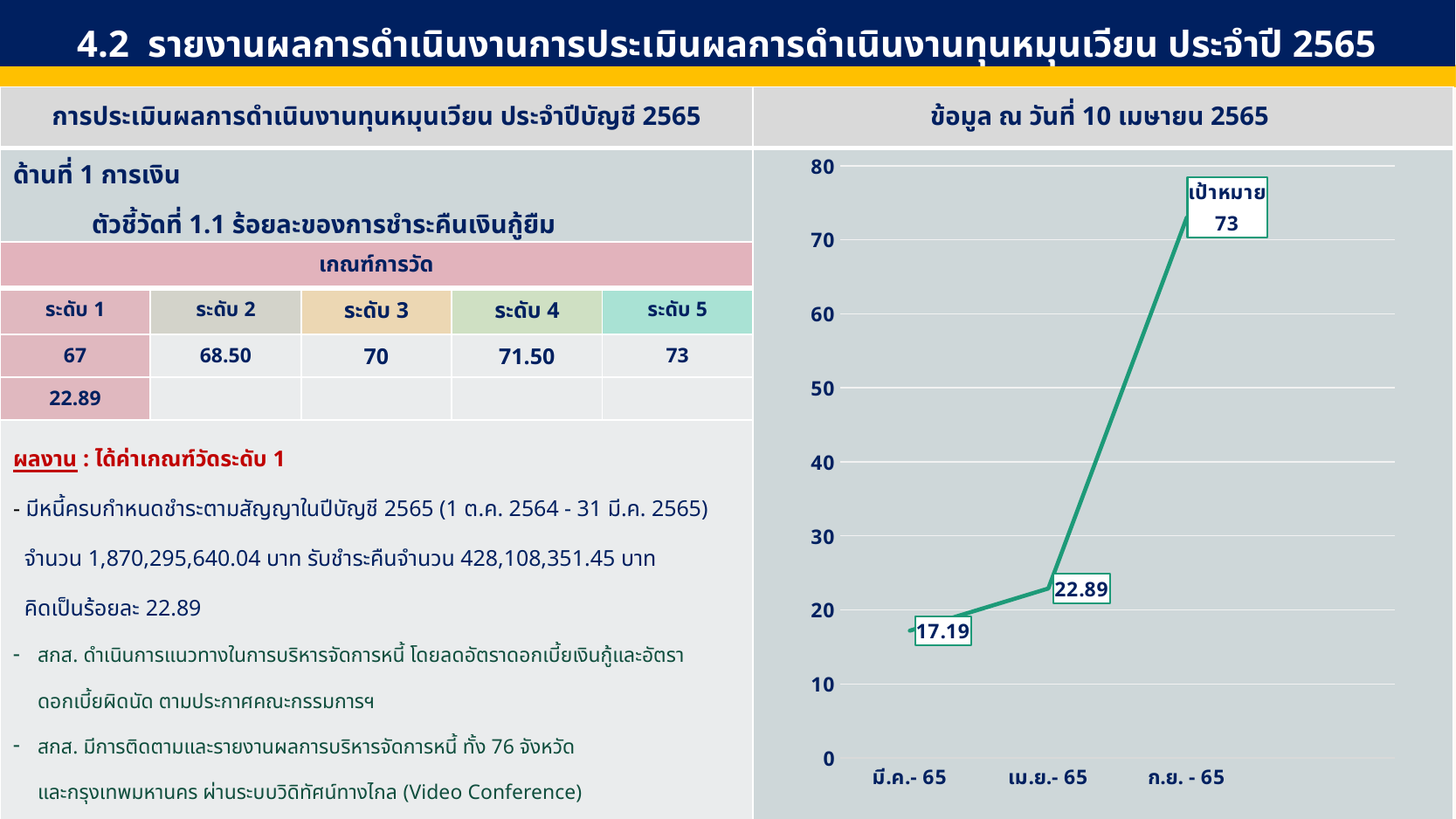
Which category has the highest value on the chart? ก.ย. - 65 What is the difference between the values for ก.ย. - 65 and เม.ย.- 65? 50.11 Do the values rise or fall from มี.ค.- 65 to ก.ย. - 65? rise How many data points are plotted on the chart? 3 What is the difference between the values for เม.ย.- 65 and มี.ค.- 65? 5.70 Which is larger, the value for เม.ย.- 65 or the value for มี.ค.- 65? เม.ย.- 65 What is the value plotted for ก.ย. - 65? 73 Which category has the lowest value on the chart? มี.ค.- 65 What is the value plotted for เม.ย.- 65? 22.89 What is the value plotted for มี.ค.- 65? 17.19 Is the value for ก.ย. - 65 greater or less than 70? greater What kind of chart is shown on the slide? line chart